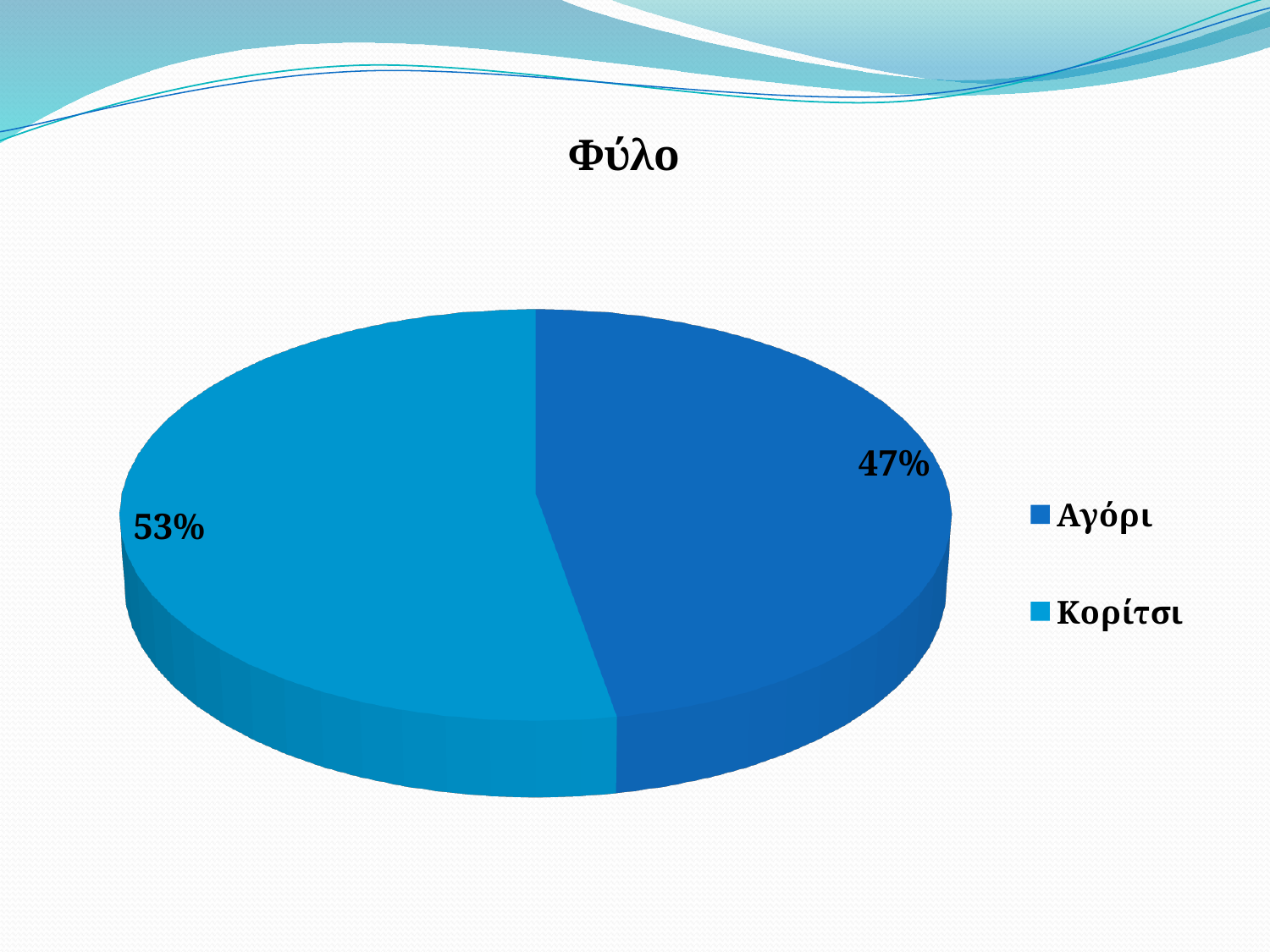
What kind of chart is shown on the slide? Pie chart Is the share for Αγόρι greater or less than 50%? less Which category has the smallest slice of the pie? Αγόρι Which legend entry is shown in the lighter blue colour? Κορίτσι How many categories does the pie chart show? 2 What share of the pie does Κορίτσι represent? 53% What is the title of the chart? Φύλο Which is larger, the share for Αγόρι or the share for Κορίτσι? Κορίτσι What is the difference in percentage points between Κορίτσι and Αγόρι? 6 Which category has the largest slice of the pie? Κορίτσι What share of the pie does Αγόρι represent? 47%